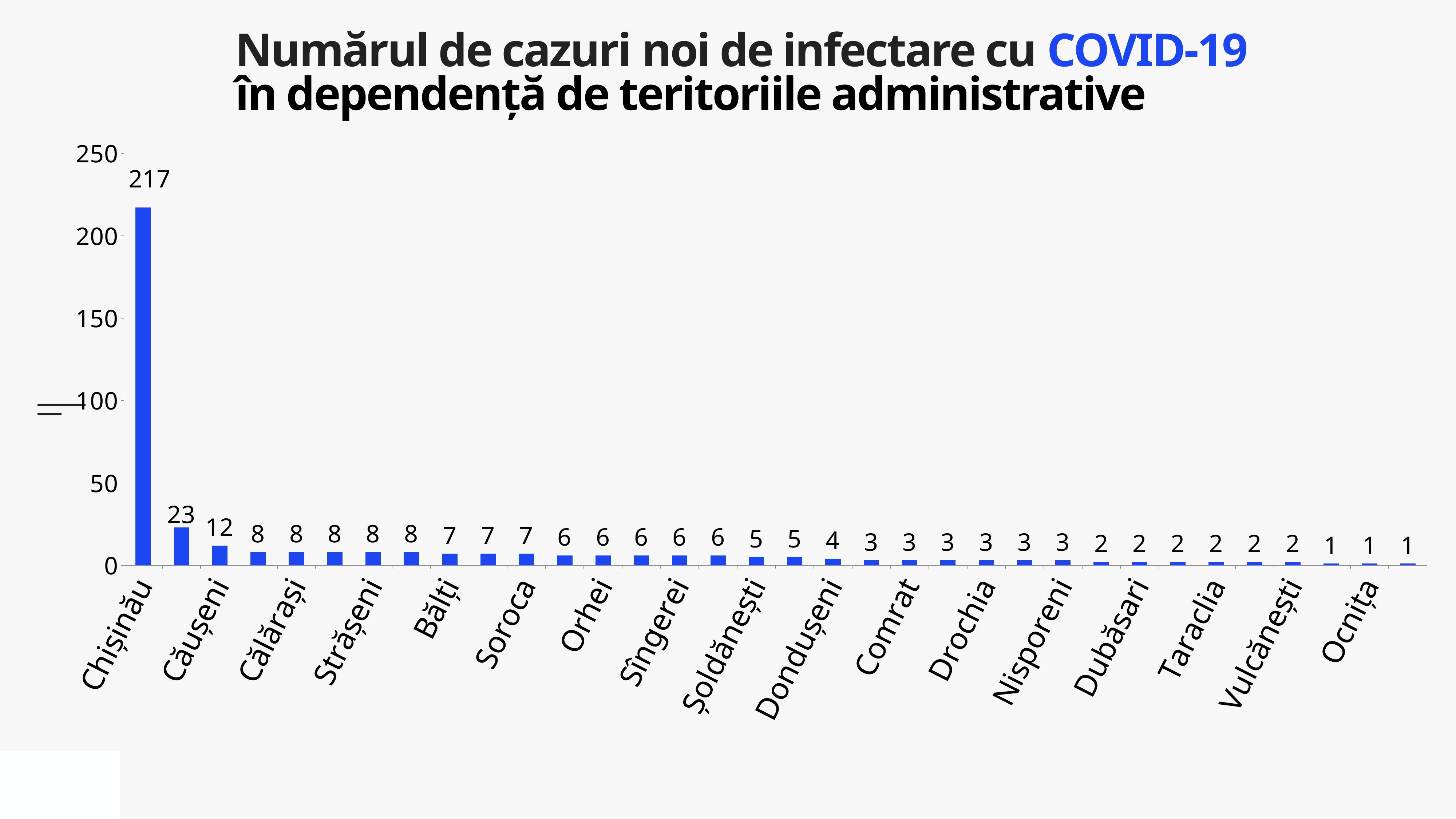
Which has more new cases, Orhei or Comrat? Orhei Is the value for Chișinău greater or less than 200? greater How many new COVID-19 cases are shown for Orhei? 6 Which administrative territory has the highest number of new COVID-19 cases? Chișinău How many new COVID-19 cases are shown for Comrat? 3 How many new COVID-19 cases are shown for Călărași? 8 What is the difference between the number of cases in Chișinău and in Ocnița? 216 What colour are the bars in the chart? blue How many new COVID-19 cases are shown for Ocnița? 1 What type of chart is shown on the slide? bar chart Do the values rise or fall moving from left to right along the x axis? fall How many new COVID-19 cases are shown for Chișinău? 217